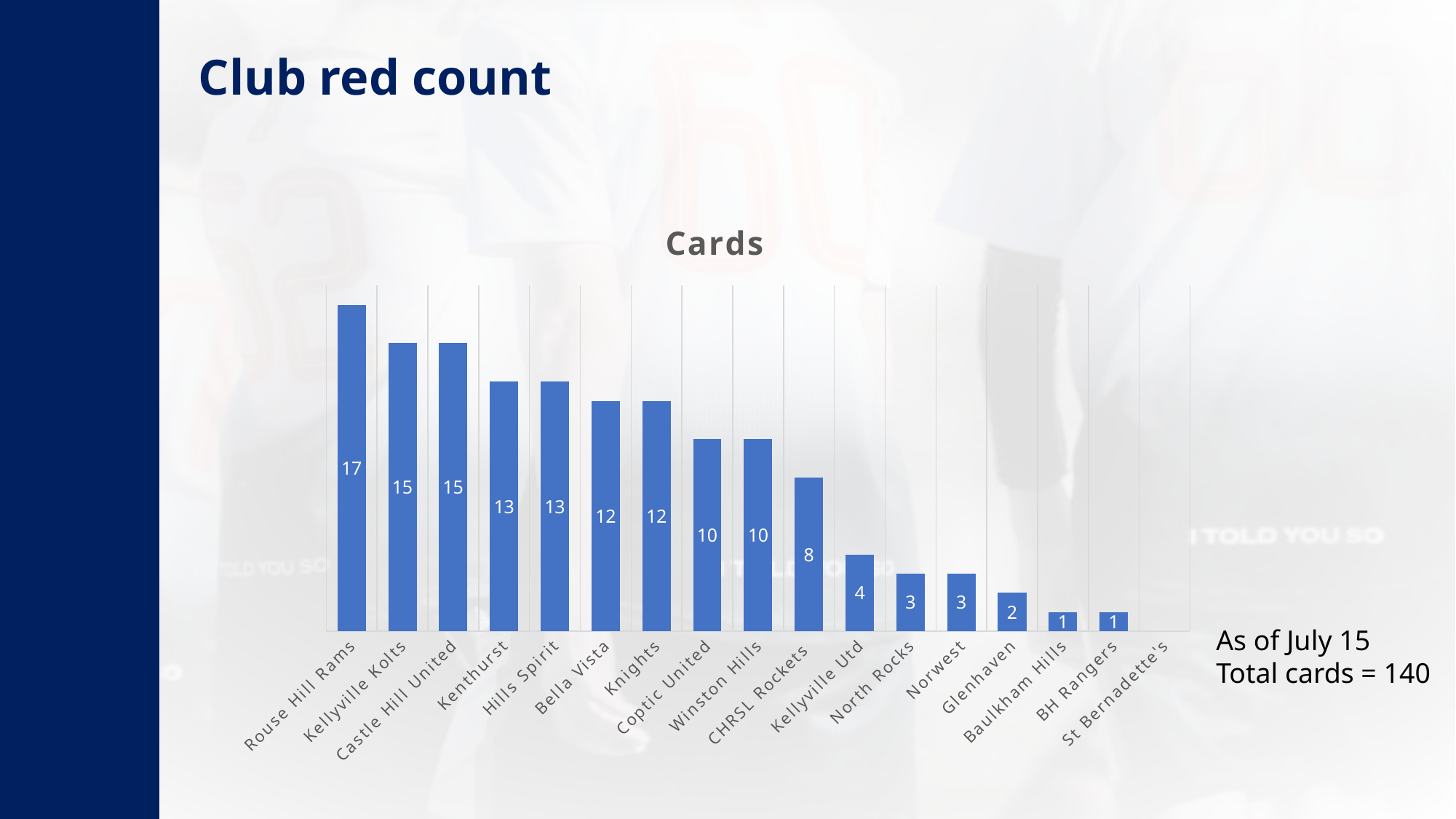
Which is larger, the value for North Rocks or the value for Baulkham Hills? North Rocks Which is larger, the value for Bella Vista or the value for Winston Hills? Bella Vista What is the value for Kenthurst? 13 What is the difference between the values for Coptic United and Kellyville Utd? 6 What is the value for Glenhaven? 2 What kind of chart is shown on the slide? Bar chart What is the title of the chart? Cards Which club has the highest number of cards? Rouse Hill Rams What is the difference between the values for Rouse Hill Rams and Kellyville Kolts? 2 How many clubs are listed on the x axis? 17 What is the value for CHRSL Rockets? 8 What is the value for Rouse Hill Rams? 17